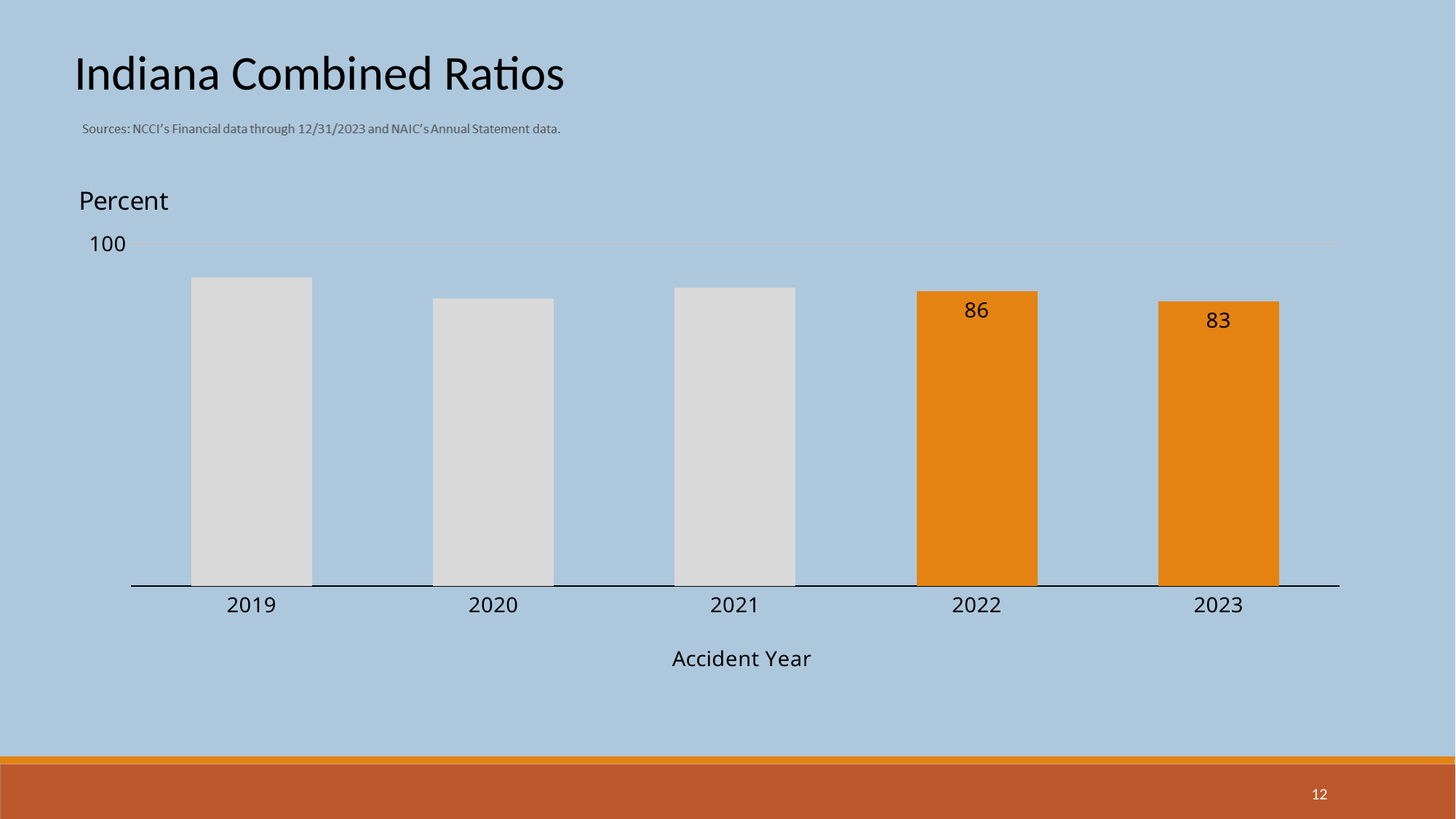
What is the combined ratio for accident year 2023? 83 How many accident years are shown on the chart? 5 What is the title of the horizontal axis? Accident Year By how many points did the combined ratio fall from 2022 to 2023? 3 Does the combined ratio rise or fall from 2022 to 2023? fall Which accident year has the higher combined ratio, 2022 or 2023? 2022 What kind of chart is shown on the slide? bar chart Is the value for 2019 greater or less than 100? less Is the value for 2021 greater or less than 100? less Which accident year has the highest combined ratio? 2019 Which accident year has the lowest combined ratio? 2023 What is the combined ratio for accident year 2022? 86